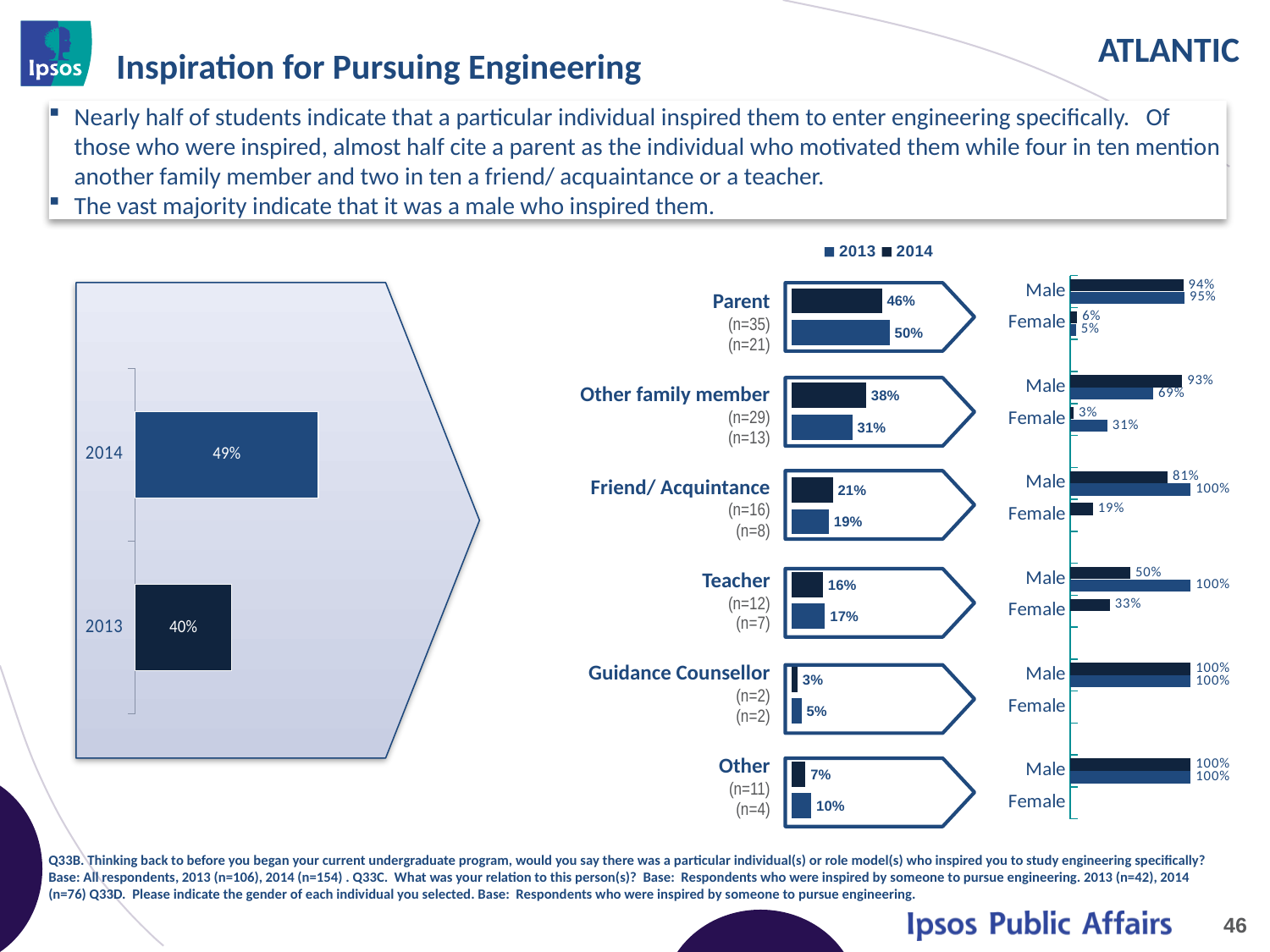
In the middle chart of relation to the inspiring person, which category has the highest 2014 value? Parent In the middle chart, is the 2013 value for Teacher larger or smaller than the 2014 value for Teacher? smaller How many series does the legend above the middle chart list? 2 In the middle chart of relation to the inspiring person, which category has the lowest 2013 value? Guidance Counsellor In the middle chart of relation to the inspiring person, what is the 2013 value for Other family member? 38% In the left chart, what is the value for 2013? 40% In the right chart showing the gender of the inspiring person, what is the 2014 value for Male under Other family member? 69% What type of chart is used in the middle of the slide to show relation to the inspiring person? Bar chart In the left chart, by how many percentage points did the value rise from 2013 to 2014? 9 percentage points In the middle chart of relation to the inspiring person, what is the 2014 value for Parent? 50% In the left chart showing the share of students inspired by a particular individual, what is the value for 2014? 49% In the middle chart of relation to the inspiring person, how many categories are shown? 6